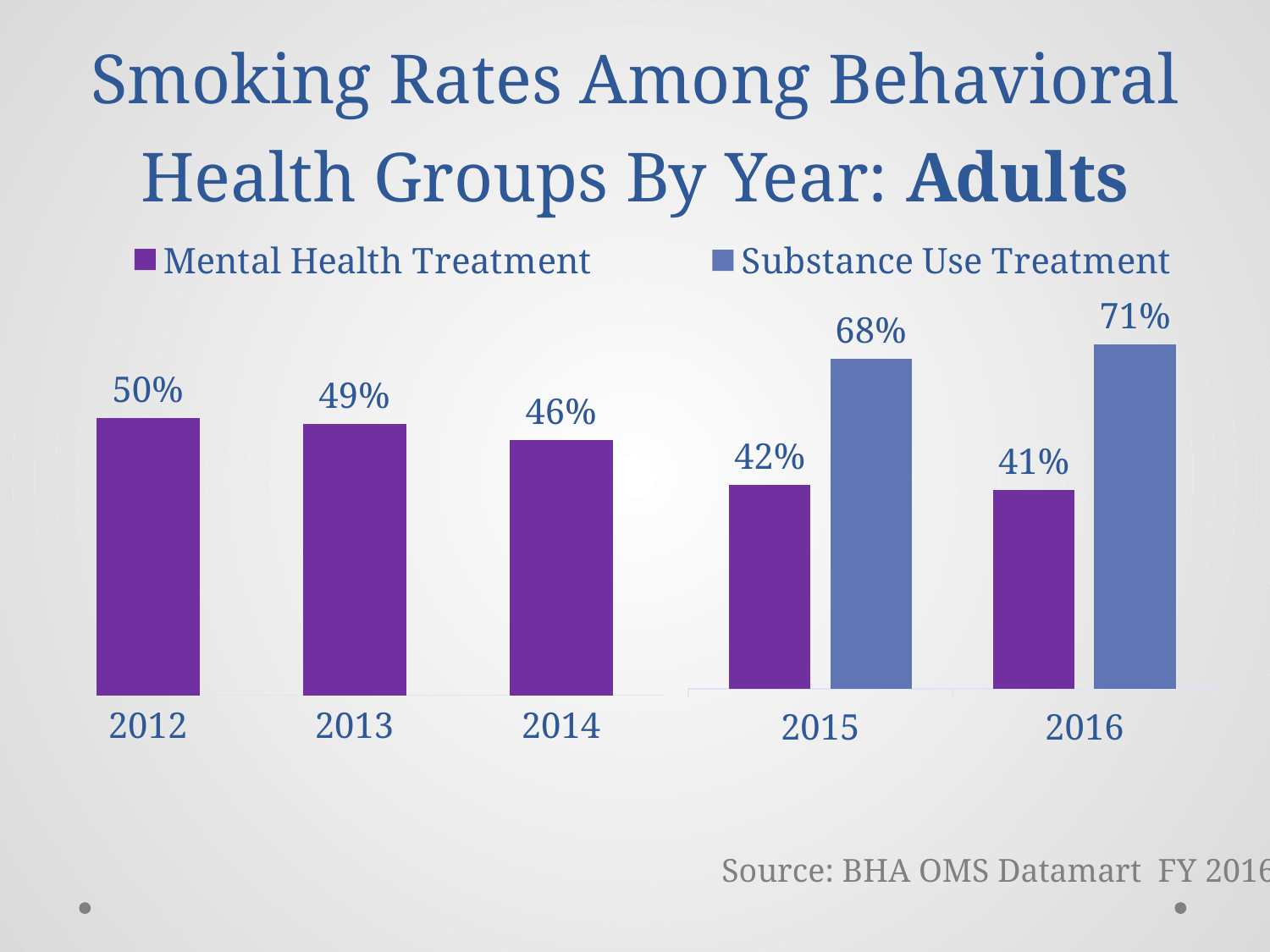
Which year has the lowest Mental Health Treatment smoking rate? 2016 What is the difference between the Mental Health Treatment rates in 2012 and 2016? 9% What is the difference between the Substance Use Treatment and Mental Health Treatment rates in 2016? 30% What is the Mental Health Treatment smoking rate for 2014? 46% How many series does the legend list? 2 How many years are shown on the x axis? 5 What is the Mental Health Treatment smoking rate for 2012? 50% Which year has the highest Mental Health Treatment smoking rate? 2012 What is the Substance Use Treatment smoking rate for 2015? 68% In 2015, which group has the higher smoking rate, Mental Health Treatment or Substance Use Treatment? Substance Use Treatment Does the Mental Health Treatment smoking rate rise or fall from 2012 to 2016? fall What is the Substance Use Treatment smoking rate for 2016? 71%